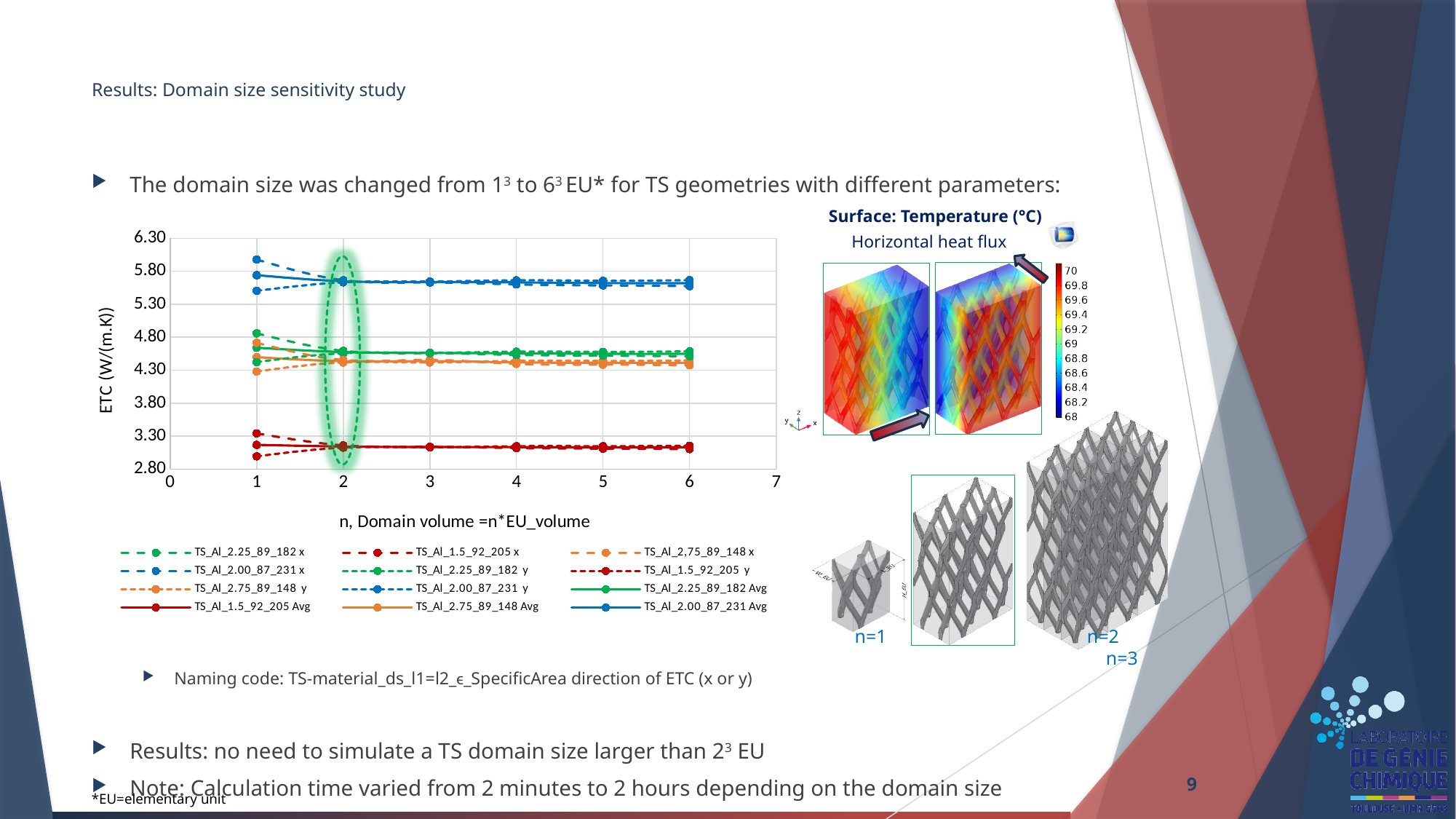
How many data points (values of n) are plotted for each series? 6 Is the value of TS_Al_2.25_89_182 x at n=1 greater or less than 4.30? greater What is the label of the x axis of the chart? n, Domain volume =n*EU_volume Is the value of TS_Al_1.5_92_205 Avg at n=6 greater or less than 3.30? less How many series does the chart legend list? 12 What kind of chart is shown on the slide? line chart What is the label of the y axis of the chart? ETC (W/(m.K)) Which geometry has the highest ETC values across all domain sizes? TS_Al_2.00_87_231 At n=1, which is larger: the value of TS_Al_2.25_89_182 x or TS_Al_2.75_89_148 x? TS_Al_2.25_89_182 x Is the value of TS_Al_2.00_87_231 Avg at n=1 greater or less than 5.30? greater Which geometry has the lowest ETC values across all domain sizes? TS_Al_1.5_92_205